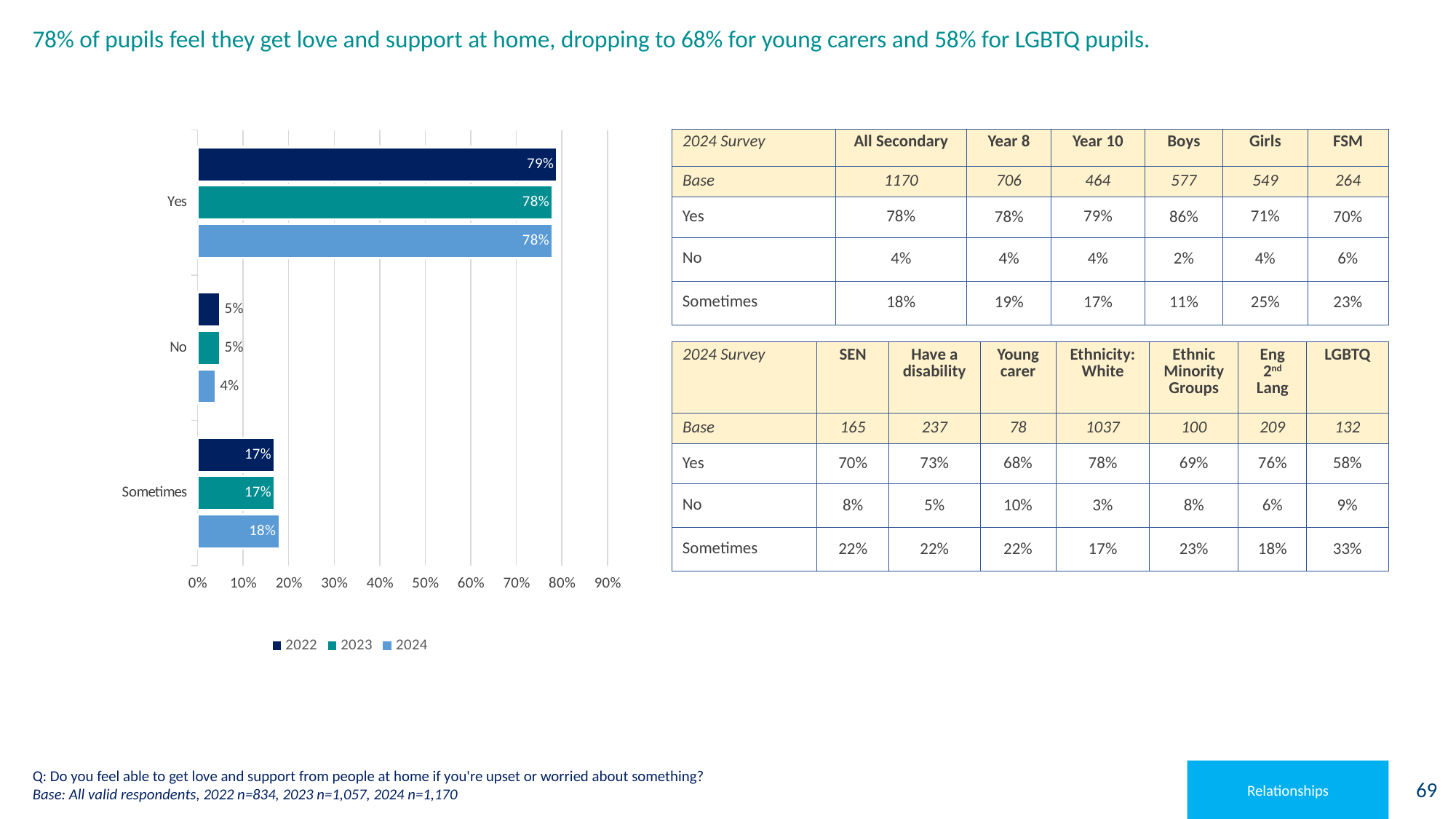
What kind of chart is shown on the slide? Bar chart How many series does the legend list? 3 Which category has the lowest value in 2022? No What is the difference between the Yes value in 2022 and the Yes value in 2024? 1% How many categories are shown on the chart? 3 Which series is shown in the darkest blue colour in the legend? 2022 Which is larger, the Sometimes value in 2024 or the Sometimes value in 2022? 2024 What is the value for Sometimes in 2023? 17% Is the value for Yes in 2023 greater or less than 70%? greater What is the value for No in 2024? 4% Which category has the highest value in 2024? Yes What is the value for Yes in 2022? 79%